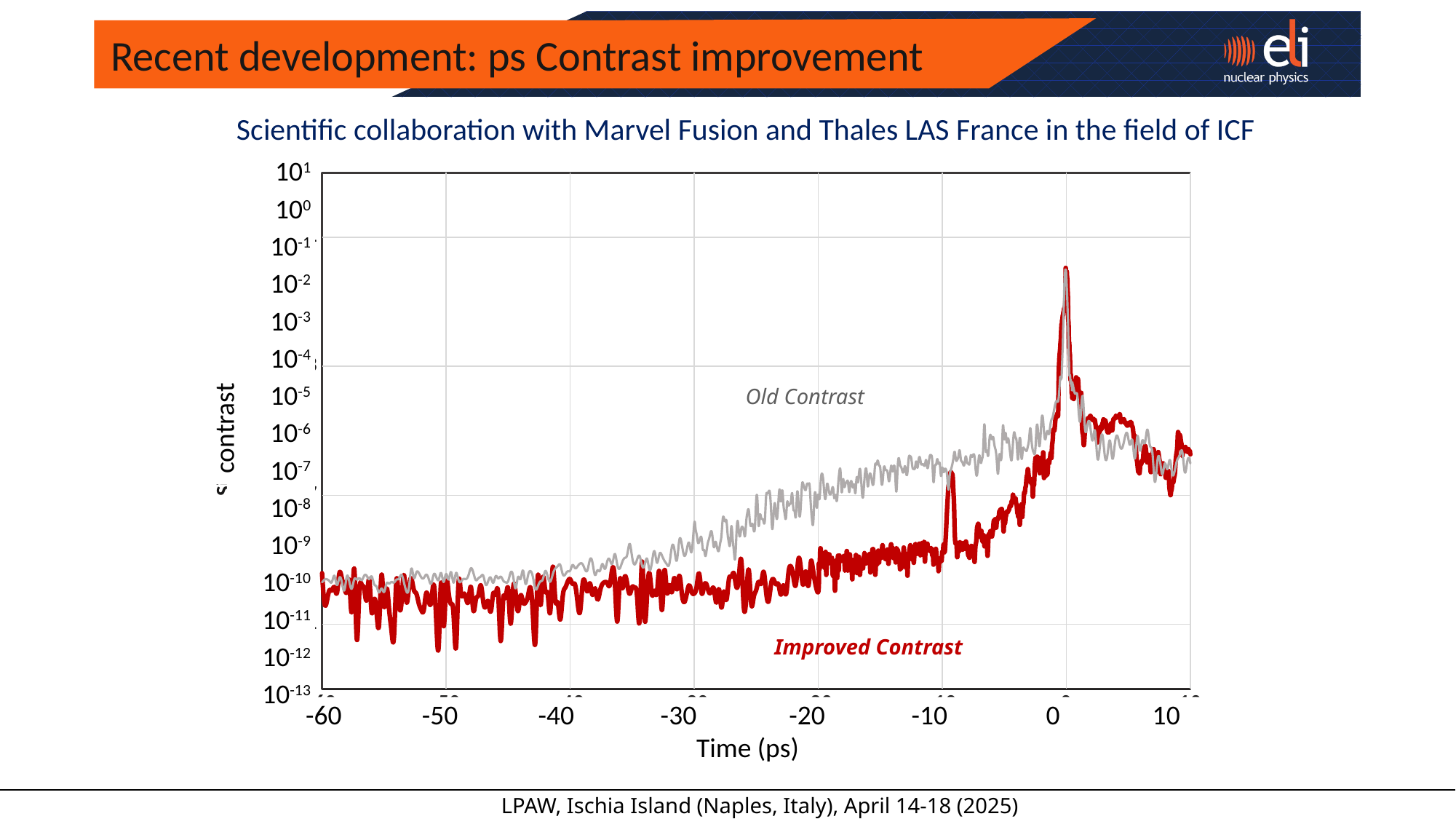
At -40 ps, is the Improved Contrast value greater or less than 10^-9? less At -20 ps, which series has the higher contrast value, Old Contrast or Improved Contrast? Old Contrast What is the label of the x axis of the chart? Time (ps) Between -60 ps and 0 ps, does the Old Contrast series generally rise or fall along the x axis? rise Around which time on the x axis do both series reach their maximum? 0 How many data series are plotted on the chart? 2 At -50 ps, is the Old Contrast value greater or less than 10^-8? less At -20 ps, is the Old Contrast value greater or less than 10^-9? greater At -30 ps, which series has the lower contrast value, Old Contrast or Improved Contrast? Improved Contrast Which colour is used for the Improved Contrast series? red What kind of chart is shown on the slide? line chart